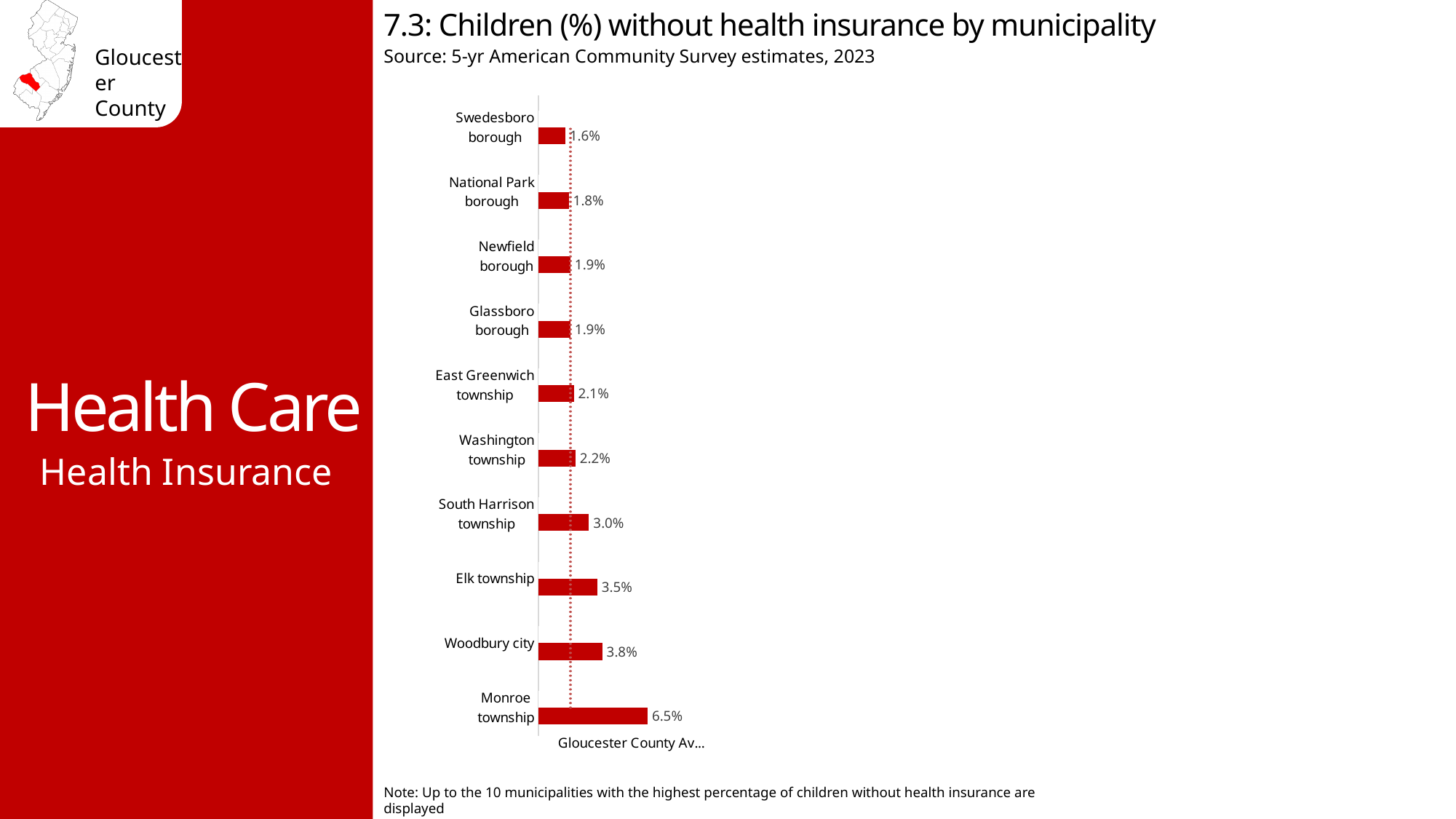
What is the value for Monroe township? 6.5% What kind of chart is shown on the slide? Bar chart What is the source cited for the chart? 5-yr American Community Survey estimates, 2023 What is the difference between the values for Monroe township and Woodbury city? 2.7% Which is larger, the value for Elk township or the value for East Greenwich township? Elk township What is the value for Washington township? 2.2% Which municipality has the highest percentage of children without health insurance? Monroe township Which municipality has the lowest percentage of children without health insurance? Swedesboro borough What is the difference between the values for South Harrison township and National Park borough? 1.2% What is the value for Elk township? 3.5% What is the value for Swedesboro borough? 1.6% How many municipalities are shown in the chart? 10